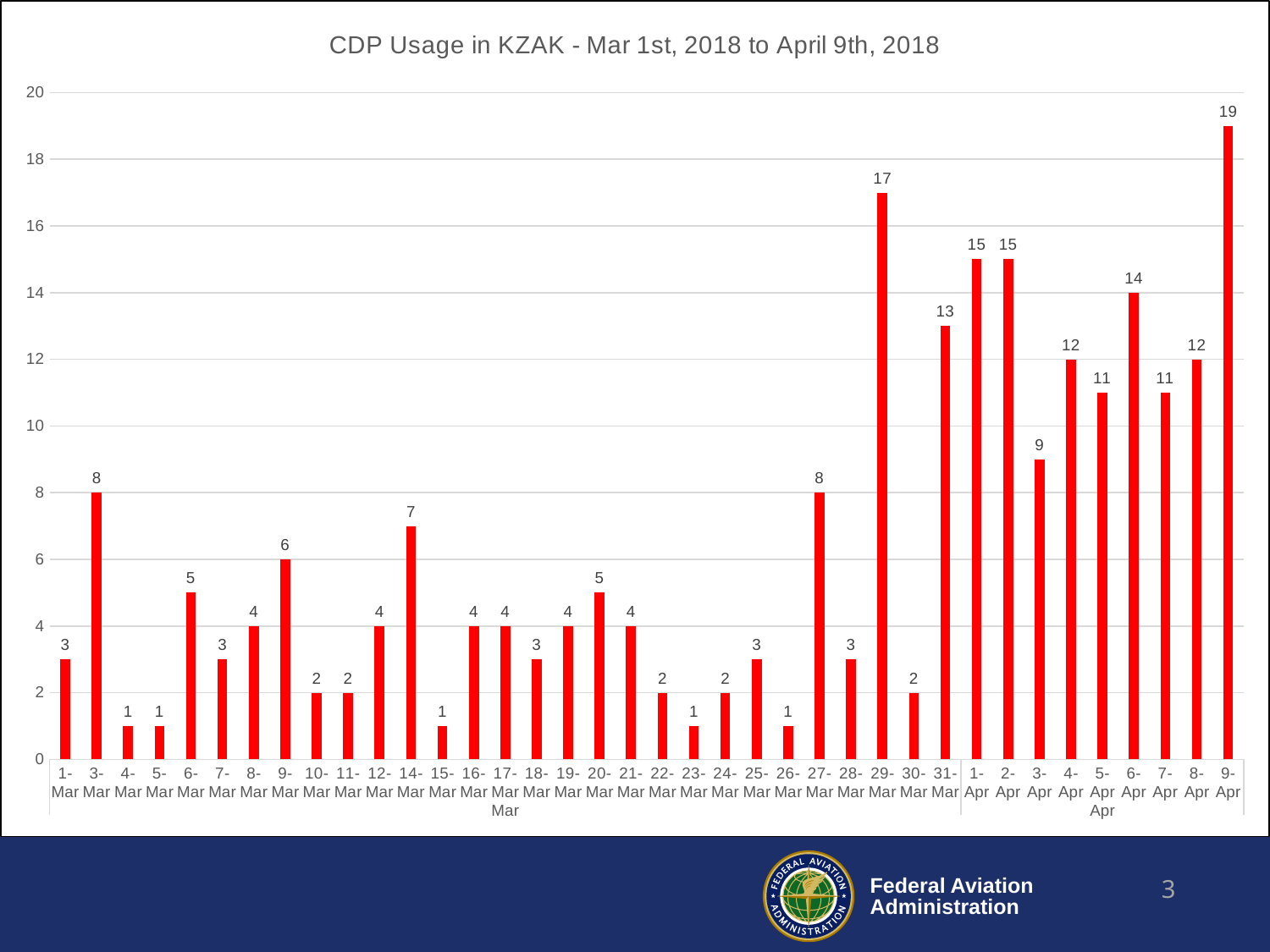
What is the difference between the values for 9-Apr and 29-Mar? 2 What is the value for 14-Mar? 7 Which date has the highest value? 9-Apr What is the value for 29-Mar? 17 What is the difference between the values for 31-Mar and 30-Mar? 11 Is the value for 1-Apr greater or less than 10? greater What is the value for 3-Apr? 9 How many dates (bars) are shown on the chart? 38 What kind of chart is this? Bar chart Which is larger, the value for 6-Apr or the value for 4-Apr? 6-Apr What is the title of the chart? CDP Usage in KZAK - Mar 1st, 2018 to April 9th, 2018 What is the lowest value shown on the chart? 1